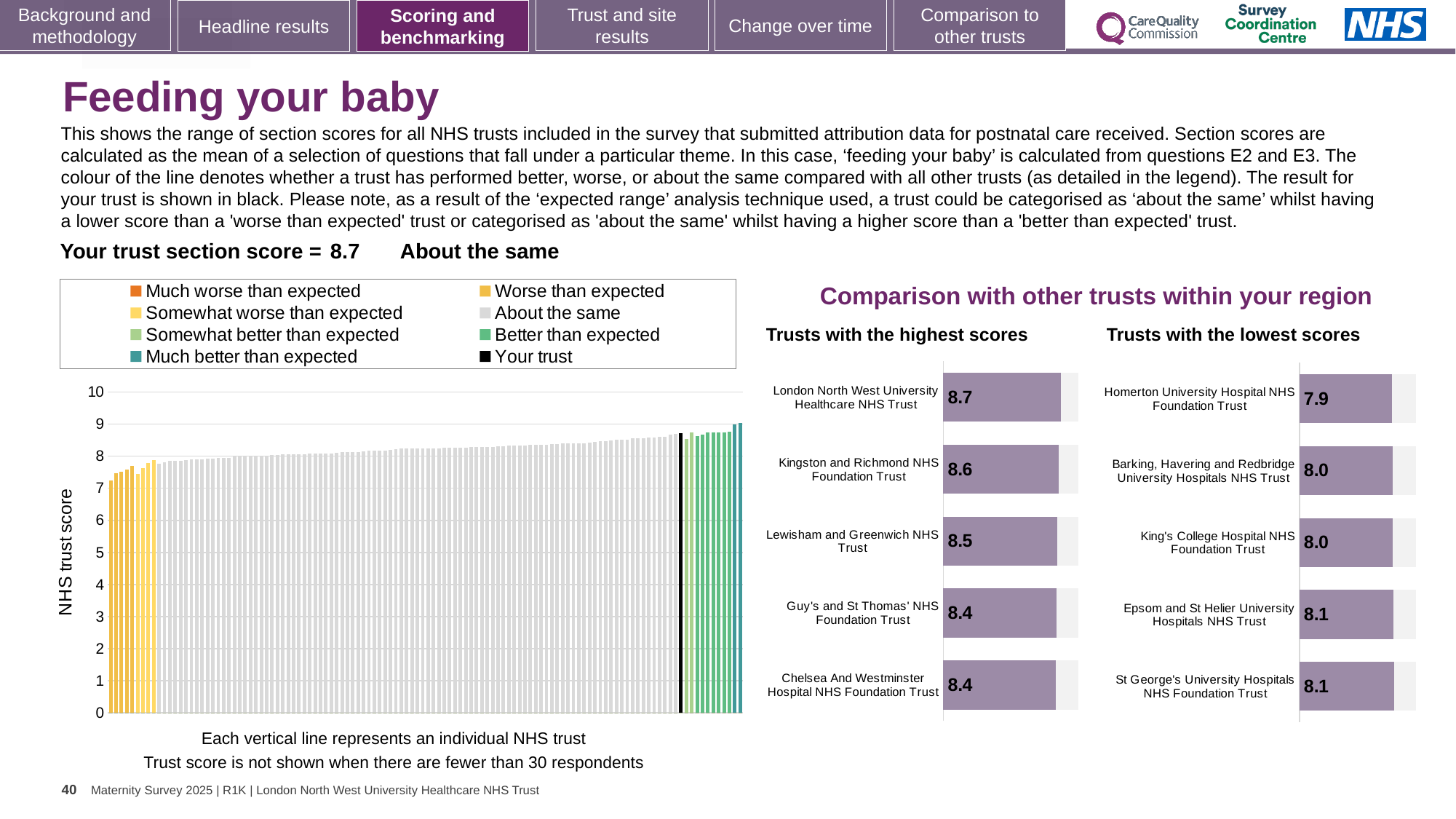
How many entries does the legend of the main 'NHS trust score' bar chart list? 8 What kind of chart is the main chart on the left with the 'NHS trust score' axis? Bar chart In the main 'NHS trust score' chart, is the value of the black 'Your trust' bar greater or less than 8? greater In the 'Trusts with the highest scores' chart, which trust has the highest score? London North West University Healthcare NHS Trust In the 'Trusts with the highest scores' chart, what is the score for Kingston and Richmond NHS Foundation Trust? 8.6 In the main 'NHS trust score' chart, do the values rise or fall from left to right along the x axis? Rise In the 'Trusts with the highest scores' chart, what is the difference between the scores of London North West University Healthcare NHS Trust and Lewisham and Greenwich NHS Trust? 0.2 In the 'Trusts with the lowest scores' chart, which trust has the lowest score? Homerton University Hospital NHS Foundation Trust How many trusts are shown in the 'Trusts with the highest scores' chart? 5 In the 'Trusts with the lowest scores' chart, what is the score for St George's University Hospitals NHS Foundation Trust? 8.1 In the 'Trusts with the lowest scores' chart, what is the score for Homerton University Hospital NHS Foundation Trust? 7.9 In the 'Trusts with the lowest scores' chart, which has the higher score: Epsom and St Helier University Hospitals NHS Trust or Barking, Havering and Redbridge University Hospitals NHS Trust? Epsom and St Helier University Hospitals NHS Trust